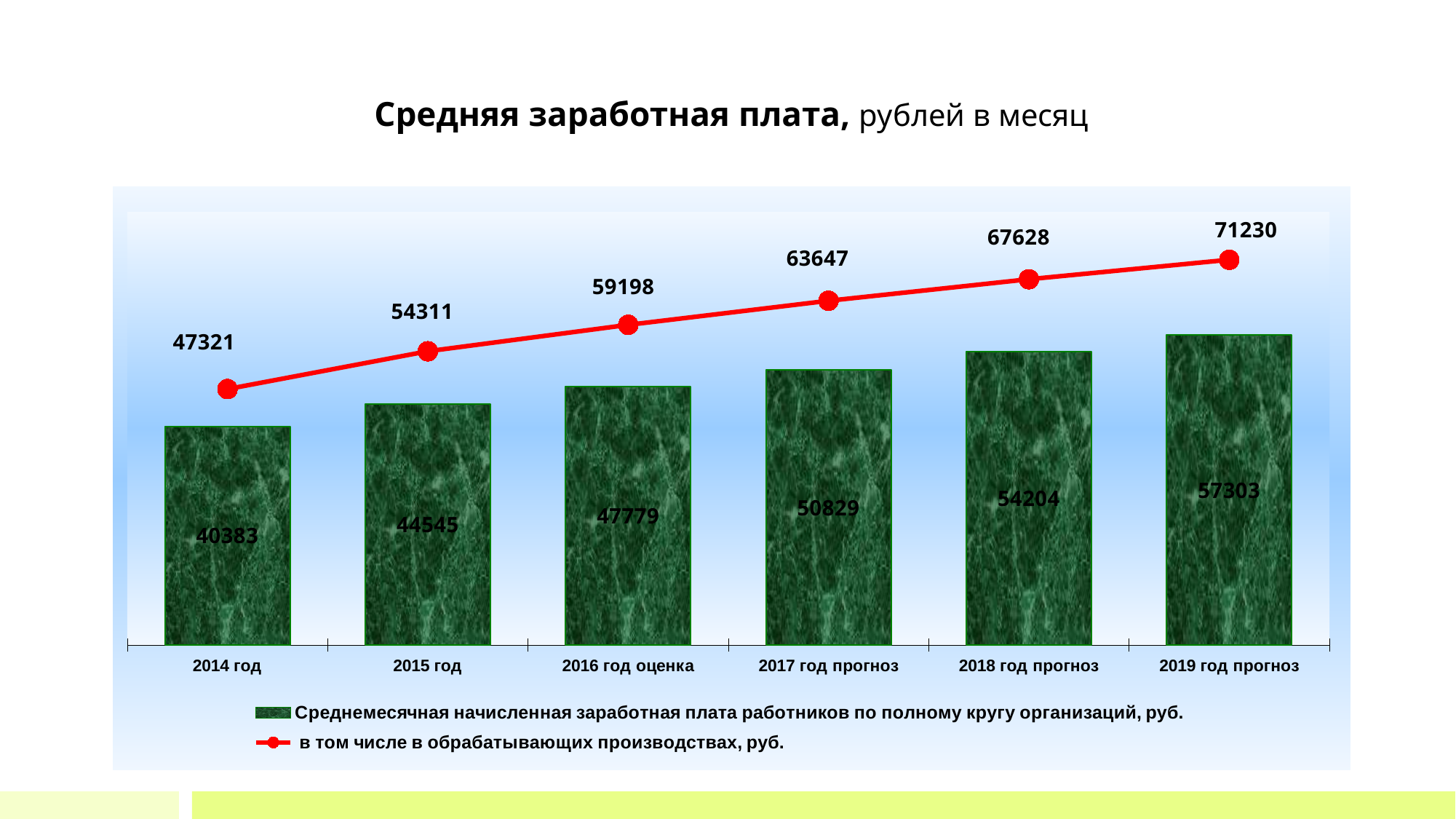
What is the value of the bar series (Среднемесячная начисленная заработная плата работников по полному кругу организаций) for 2014 год? 40383 What is the title of the chart? Средняя заработная плата, рублей в месяц How many years are shown on the x axis? 6 Which year has the lowest value for the bar series? 2014 год What is the difference between the line series value and the bar series value for 2016 год оценка? 11419 Which is larger for 2018 год прогноз: the bar series value or the line series value? the line series value (67628) What kind of chart is shown on the slide? a combined bar and line chart What is the value of the line series (в том числе в обрабатывающих производствах) for 2017 год прогноз? 63647 What is the value of the bar series for 2019 год прогноз? 57303 Which year has the highest value for the line series (в том числе в обрабатывающих производствах)? 2019 год прогноз How many series does the legend list? 2 Do the values of the bar series rise or fall from 2014 год to 2019 год прогноз? rise